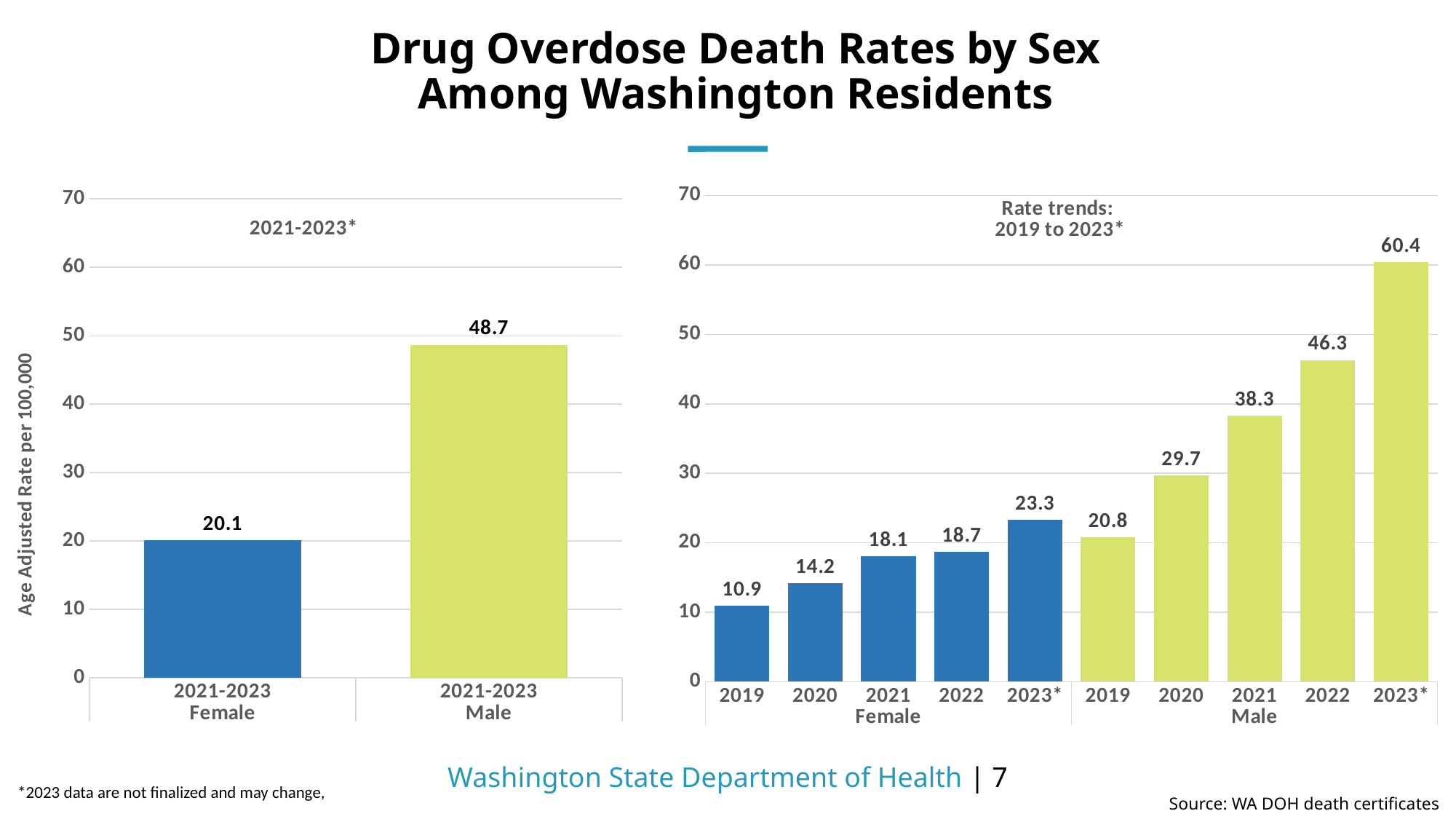
What type of chart is the left chart (2021-2023*)? bar chart How many bars are shown in the right chart (Rate trends: 2019 to 2023*)? 10 In the right chart (Rate trends: 2019 to 2023*), what is the Male rate for 2023*? 60.4 In the right chart (Rate trends: 2019 to 2023*), what is the Female rate for 2019? 10.9 In the left chart (2021-2023*), what is the age adjusted rate for Male? 48.7 In the right chart (Rate trends: 2019 to 2023*), what is the difference between the Male rate in 2023* and the Male rate in 2019? 39.6 In the right chart (Rate trends: 2019 to 2023*), which bar is the highest? Male 2023* In the right chart (Rate trends: 2019 to 2023*), which bar is the lowest? Female 2019 In the right chart (Rate trends: 2019 to 2023*), which is larger: the Female rate in 2023* or the Male rate in 2019? Female rate in 2023* In the right chart (Rate trends: 2019 to 2023*), do the Male rates rise or fall from 2019 to 2023*? rise In the left chart (2021-2023*), what is the age adjusted rate for Female? 20.1 In the left chart (2021-2023*), what is the difference between the Male and Female rates? 28.6